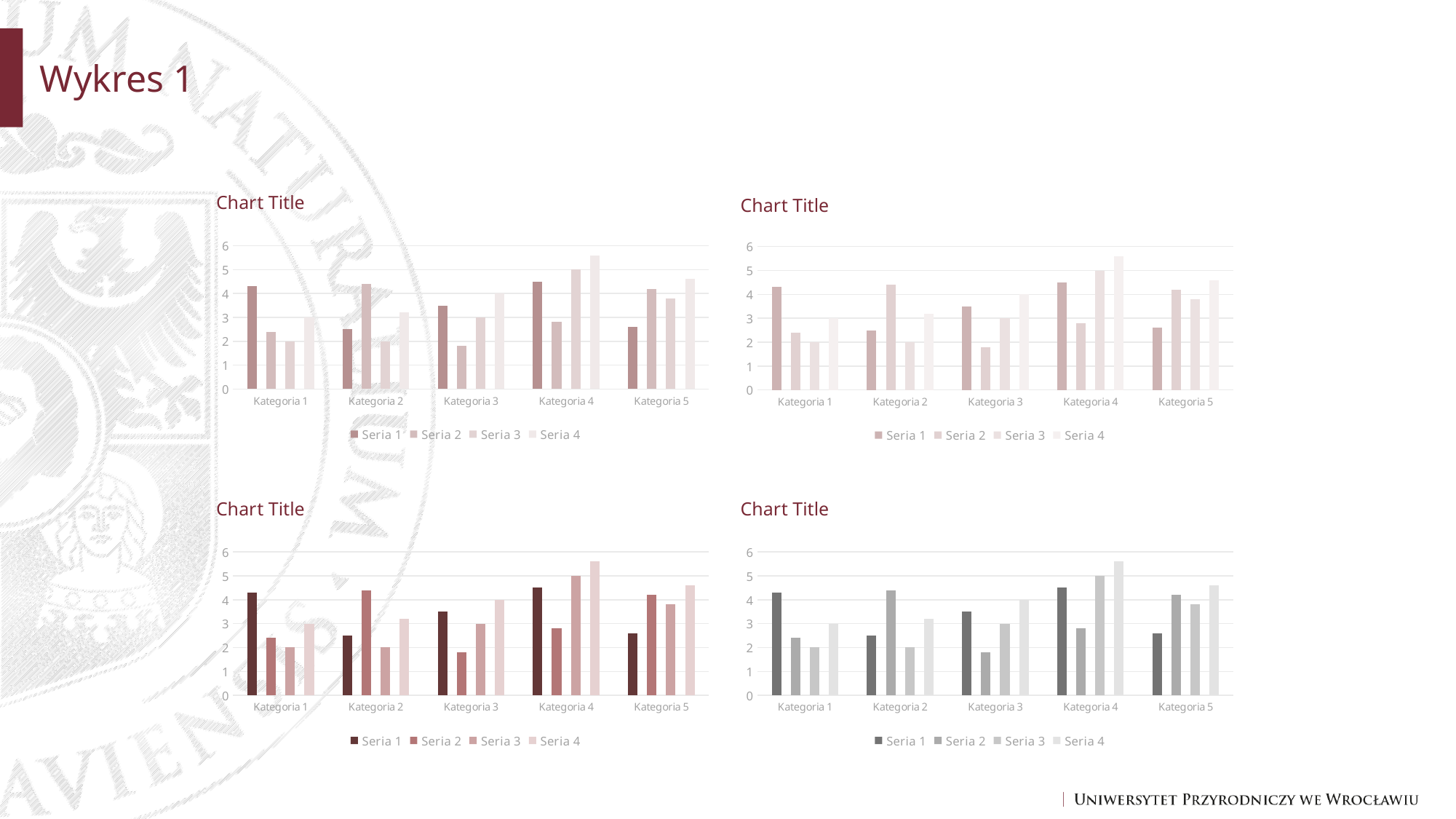
What kind of chart is the top-left chart on the slide? bar chart In the bottom-left chart, which category has the highest Seria 4 bar? Kategoria 4 What is the title shown above the bottom-right chart? Chart Title How many categories are shown on the x axis of the bottom-right chart? 5 How many series does the legend of the top-right chart list? 4 In the bottom-right chart, is the value for Seria 2 in Kategoria 3 greater or less than 2? less In the bottom-left chart, which is larger in Kategoria 2: Seria 1 or Seria 2? Seria 2 In the top-right chart, is the value for Seria 1 in Kategoria 1 greater or less than 4? greater Which of the four charts uses grey bars instead of red/pink bars? the bottom-right chart In the top-left chart, what is the value of Seria 3 in Kategoria 4? 5 In the top-left chart, which category has the lowest Seria 2 bar? Kategoria 3 In the bottom-right chart, what is the value of Seria 4 in Kategoria 3? 4